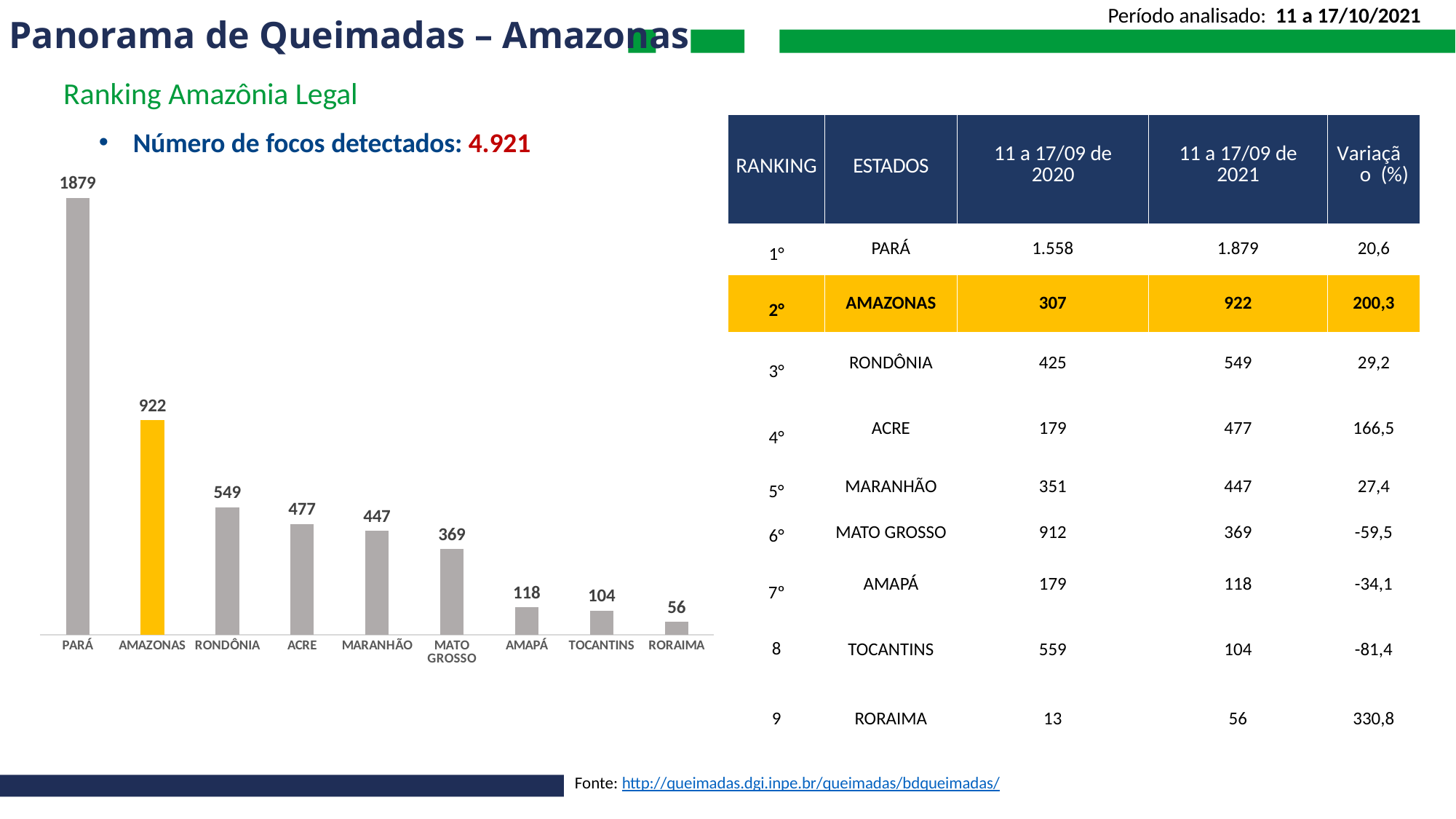
Which state has the highest bar in the chart? PARÁ What is the value for MATO GROSSO in the bar chart? 369 Which is larger in the bar chart, the value for ACRE or the value for MARANHÃO? ACRE What is the value for AMAZONAS in the bar chart? 922 What is the value for RORAIMA in the bar chart? 56 What is the difference between the values for PARÁ and AMAZONAS in the bar chart? 957 Which state has the lowest bar in the chart? RORAIMA Do the bar values rise or fall from left to right across the chart? fall What type of chart is shown on the slide? bar chart What is the value for PARÁ in the bar chart? 1879 Which state's bar is highlighted in yellow in the chart? AMAZONAS How many states are shown in the bar chart? 9